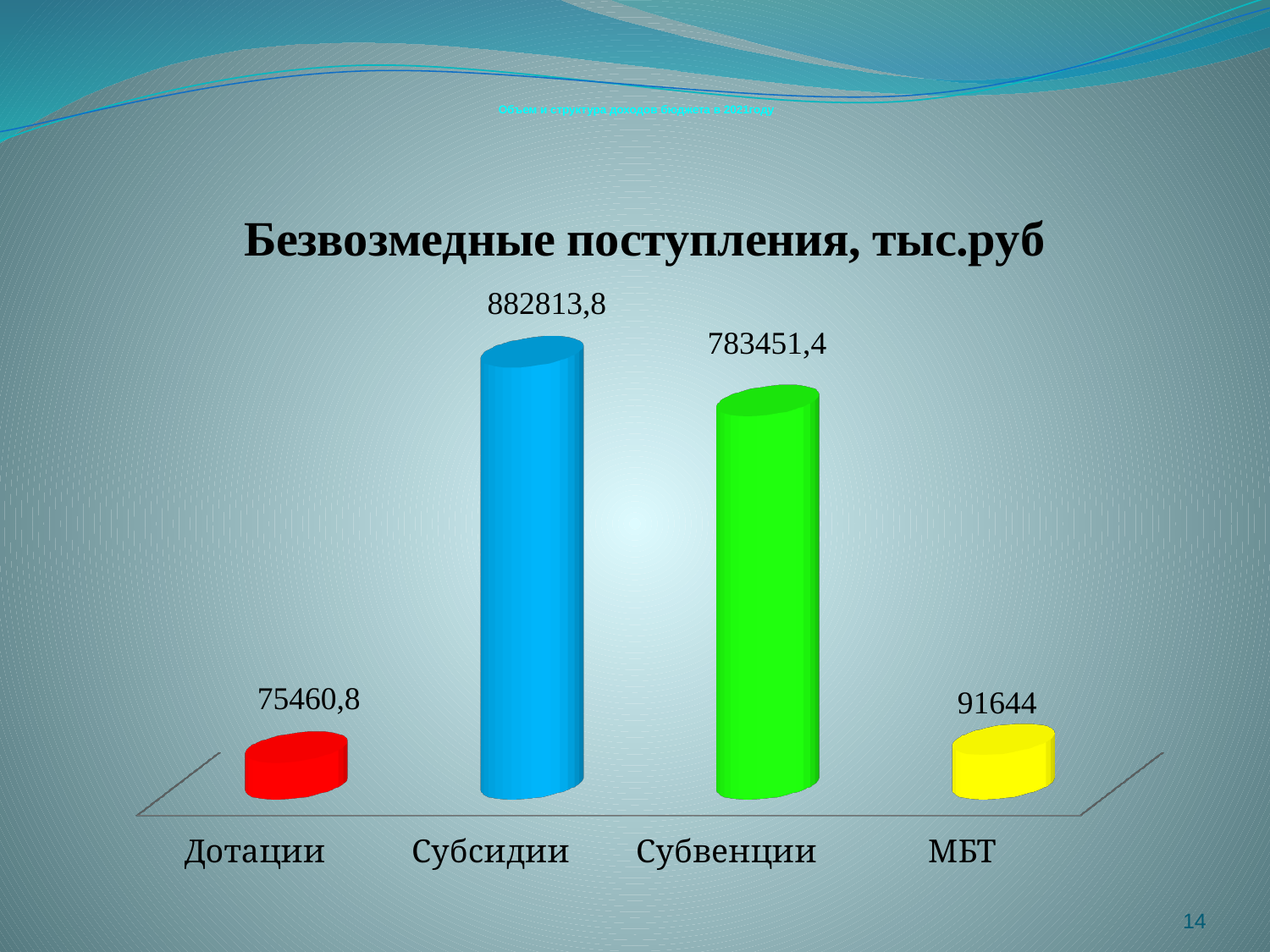
What is the value for Субвенции? 783451,4 Which is larger, the value for Субвенции or the value for МБТ? Субвенции What is the difference between the values for МБТ and Дотации? 16183,2 Which category has the highest value? Субсидии What is the value for Дотации? 75460,8 What kind of chart is shown on the slide? Bar chart What is the value for МБТ? 91644 What is the value for Субсидии? 882813,8 How many categories are shown in the chart? 4 What is the difference between the values for Субсидии and Субвенции? 99362,4 Which category has the lowest value? Дотации What is the title of the chart? Безвозмедные поступления, тыс.руб